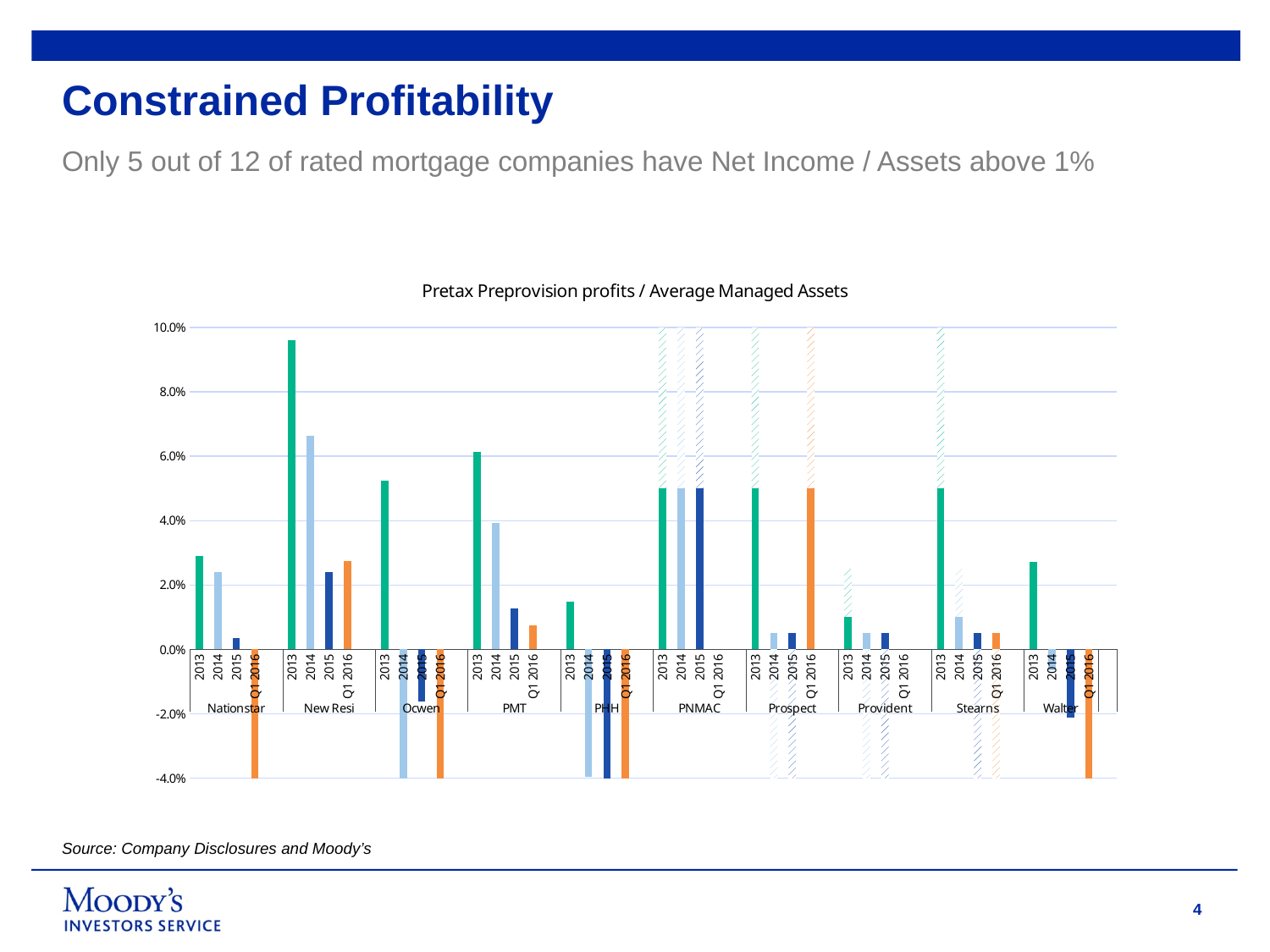
Which is larger, the 2013 value for New Resi or the 2013 value for Ocwen? New Resi How many mortgage companies are shown along the x axis of the chart? 10 What is the title of the chart? Pretax Preprovision profits / Average Managed Assets Which period has the lowest value for Nationstar? Q1 2016 Is the value for Walter in 2013 greater or less than 2.0%? greater What kind of chart is shown on the slide? bar chart Is the value for PHH in 2013 greater or less than 2.0%? less Do the values for PMT rise or fall from 2013 to Q1 2016? fall Is the value for Nationstar in 2013 greater or less than 2.0%? greater Which period has the highest value for New Resi? 2013